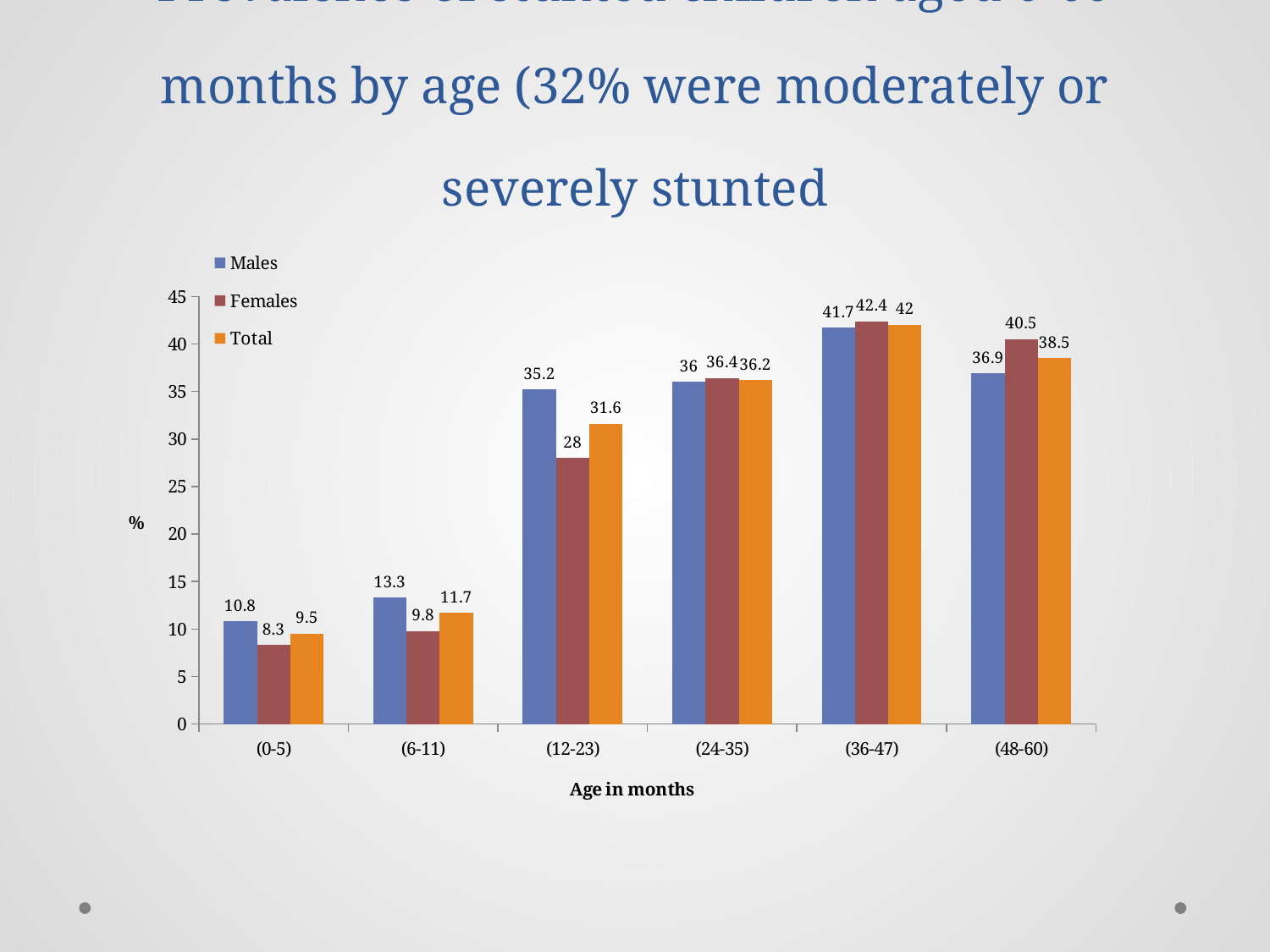
How many series does the legend list? 3 What is the Males value for the (12-23) age group? 35.2 What kind of chart is shown on the slide? bar chart What is the Females value for the (0-5) age group? 8.3 Which is larger for the (48-60) age group, the Males value or the Females value? Females Is the Total value for the (6-11) age group greater or less than 15? less Which age group has the lowest Females value? (0-5) How many age groups are shown on the x axis? 6 What is the difference between the Males and Females values for the (12-23) age group? 7.2 Which age group has the highest Total value? (36-47) What is the label of the x axis? Age in months What is the Total value for the (48-60) age group? 38.5